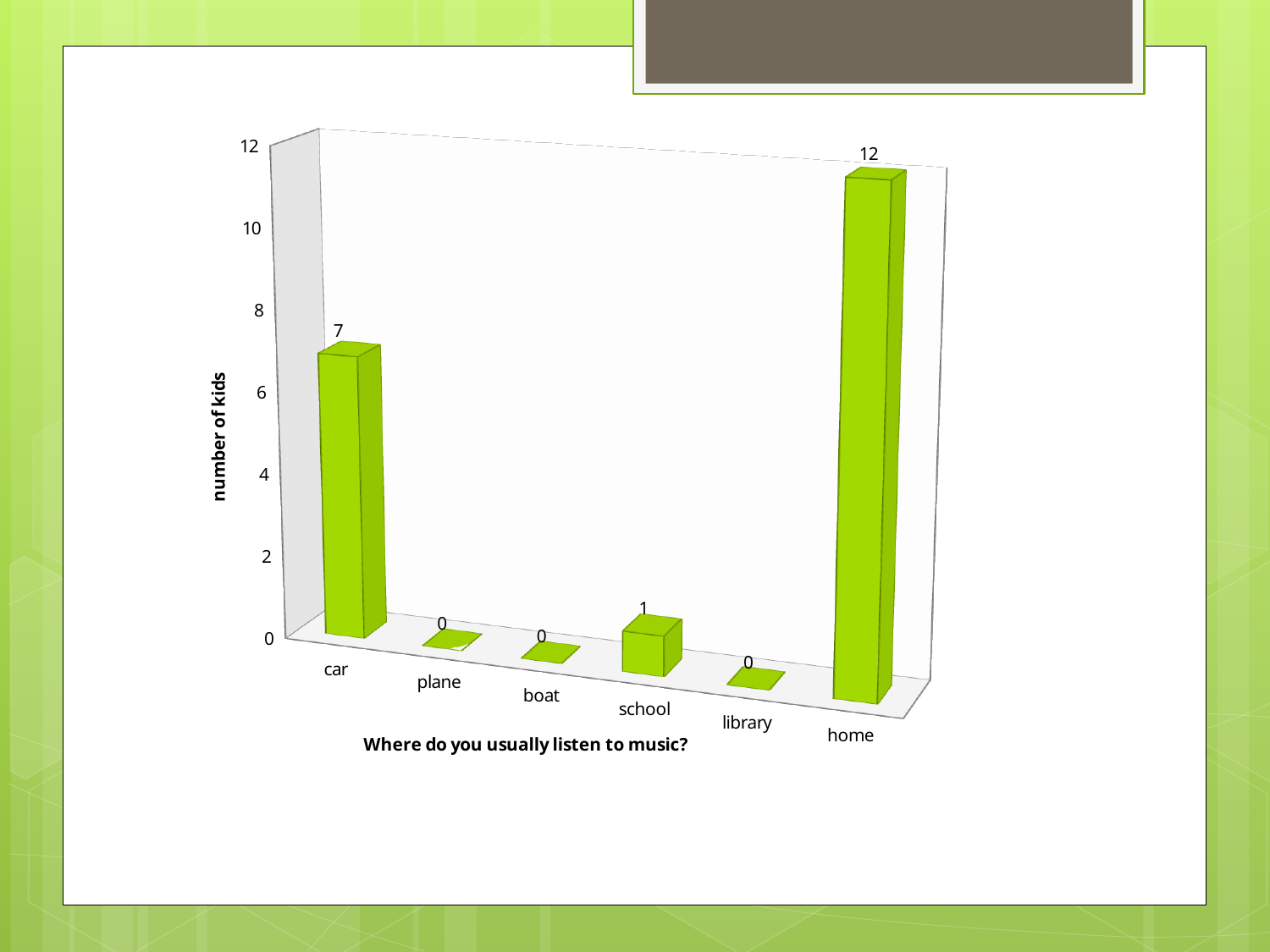
What is the difference between the values for home and car? 5 Which category has the highest number of kids? home What is the label of the horizontal axis? Where do you usually listen to music? Is the value for home greater or less than 10? greater What is the value for school? 1 What is the value for library? 0 What is the label of the vertical axis? number of kids What kind of chart is shown on the slide? bar chart What is the value for home? 12 How many kids usually listen to music in the car? 7 Which is larger, the value for car or the value for school? car How many categories are shown on the x axis? 6